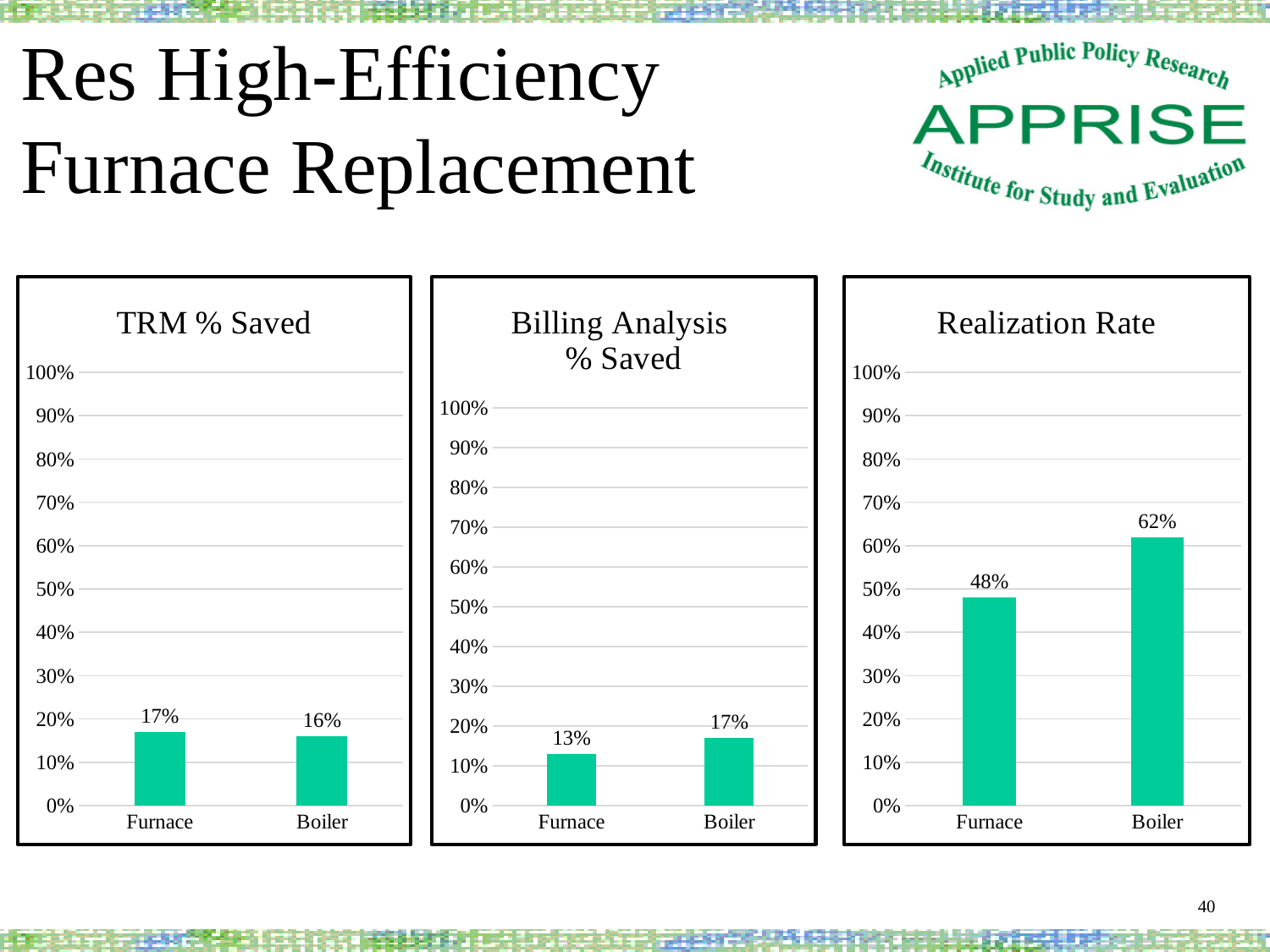
In the 'TRM % Saved' chart, what is the value for Boiler? 16% In the 'TRM % Saved' chart, what is the value for Furnace? 17% How many categories are shown in the 'TRM % Saved' chart? 2 In the 'Billing Analysis % Saved' chart, what is the difference between the Boiler and Furnace values? 4% In the 'Billing Analysis % Saved' chart, what is the value for Furnace? 13% In the 'Realization Rate' chart, which category has the highest value? Boiler In the 'Realization Rate' chart, what is the difference between the Boiler and Furnace values? 14% In the 'Realization Rate' chart, what is the value for Furnace? 48% What kind of chart is the 'Realization Rate' chart? Bar chart In the 'Billing Analysis % Saved' chart, which is larger, Furnace or Boiler? Boiler In the 'Billing Analysis % Saved' chart, what is the value for Boiler? 17% How many charts are shown on the slide? 3